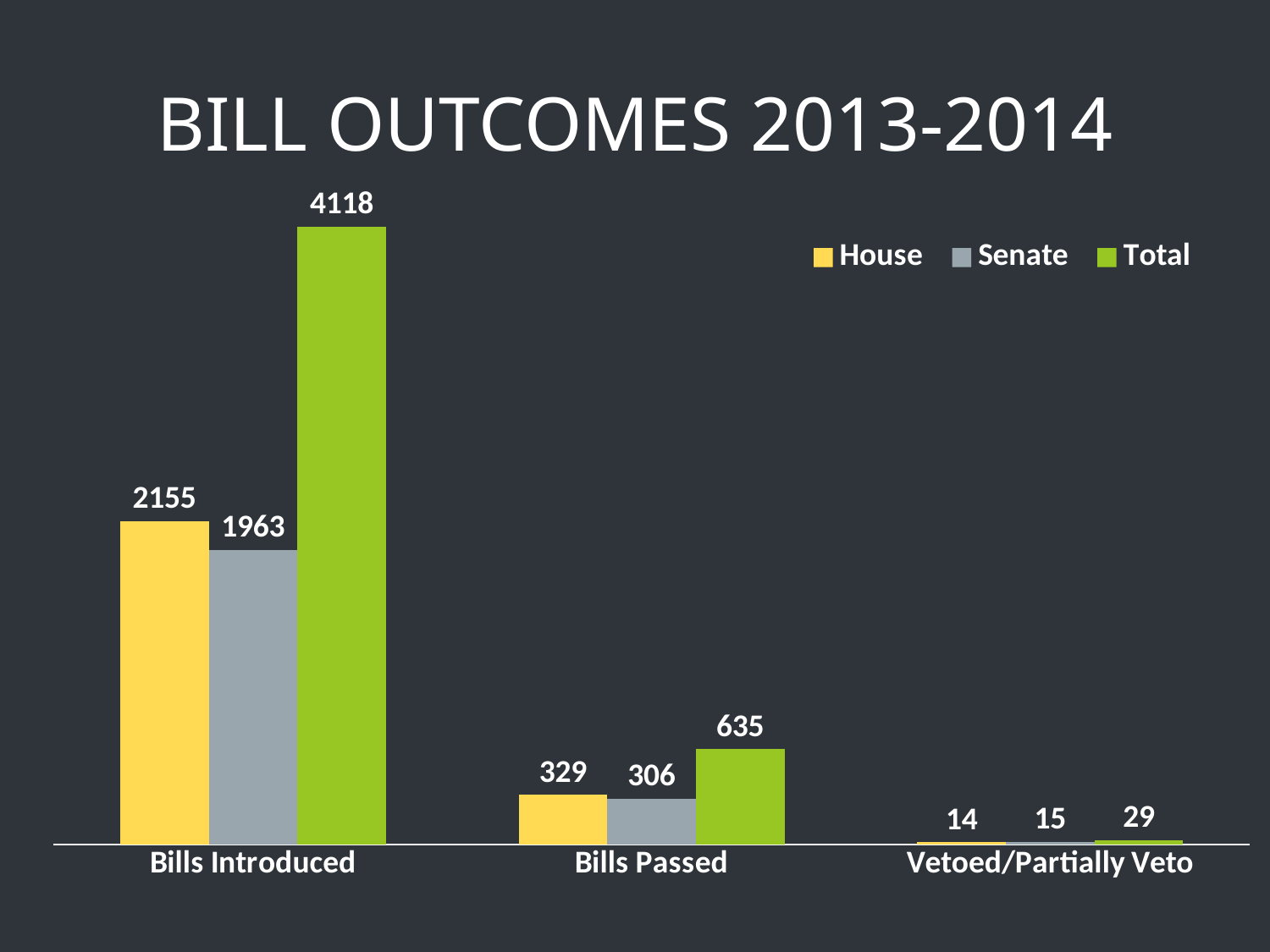
What kind of chart is shown on the slide? Bar chart Which is larger for Bills Passed, the House value or the Senate value? House Which category has the highest Total value? Bills Introduced How many series does the legend list? 3 What is the Total value for Vetoed/Partially Veto? 29 Which category has the lowest House value? Vetoed/Partially Veto What is the title of the chart? BILL OUTCOMES 2013-2014 Which is larger for Vetoed/Partially Veto, the House value or the Senate value? Senate How many categories are shown on the x axis? 3 What is the House value for Bills Introduced? 2155 What is the Senate value for Bills Passed? 306 What is the difference between the House and Senate values for Bills Introduced? 192